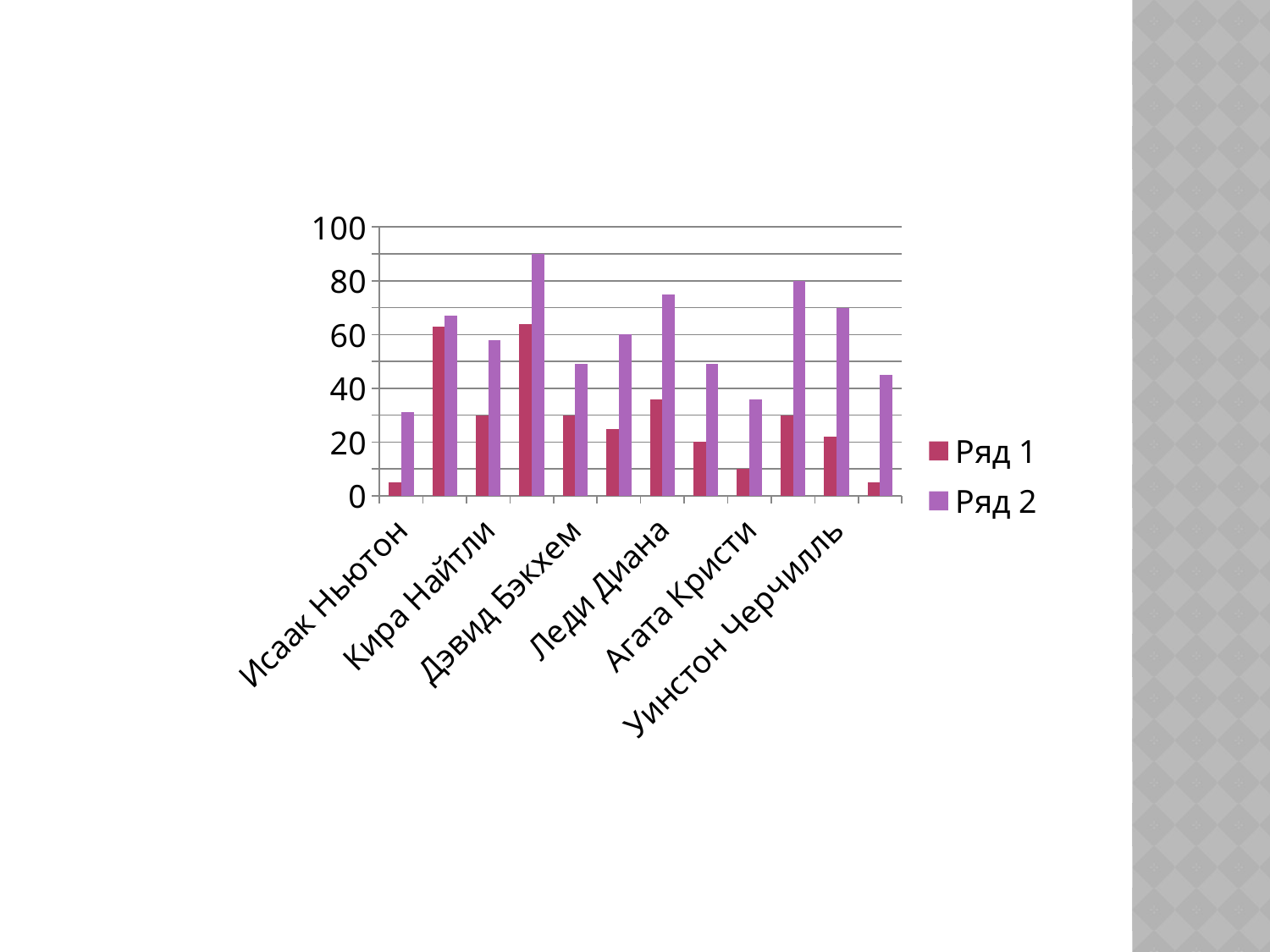
Is the Ряд 2 value for Исаак Ньютон greater or less than 20? greater Is the Ряд 1 value for Агата Кристи greater or less than 20? less Is the Ряд 2 value for Уинстон Черчилль greater or less than 60? greater What are the names of the series in the legend? Ряд 1, Ряд 2 How many series does the legend list? 2 For Леди Диана, which series has the larger value, Ряд 1 or Ряд 2? Ряд 2 Which has the larger Ряд 2 value, Леди Диана or Агата Кристи? Леди Диана What kind of chart is shown on the slide? bar chart